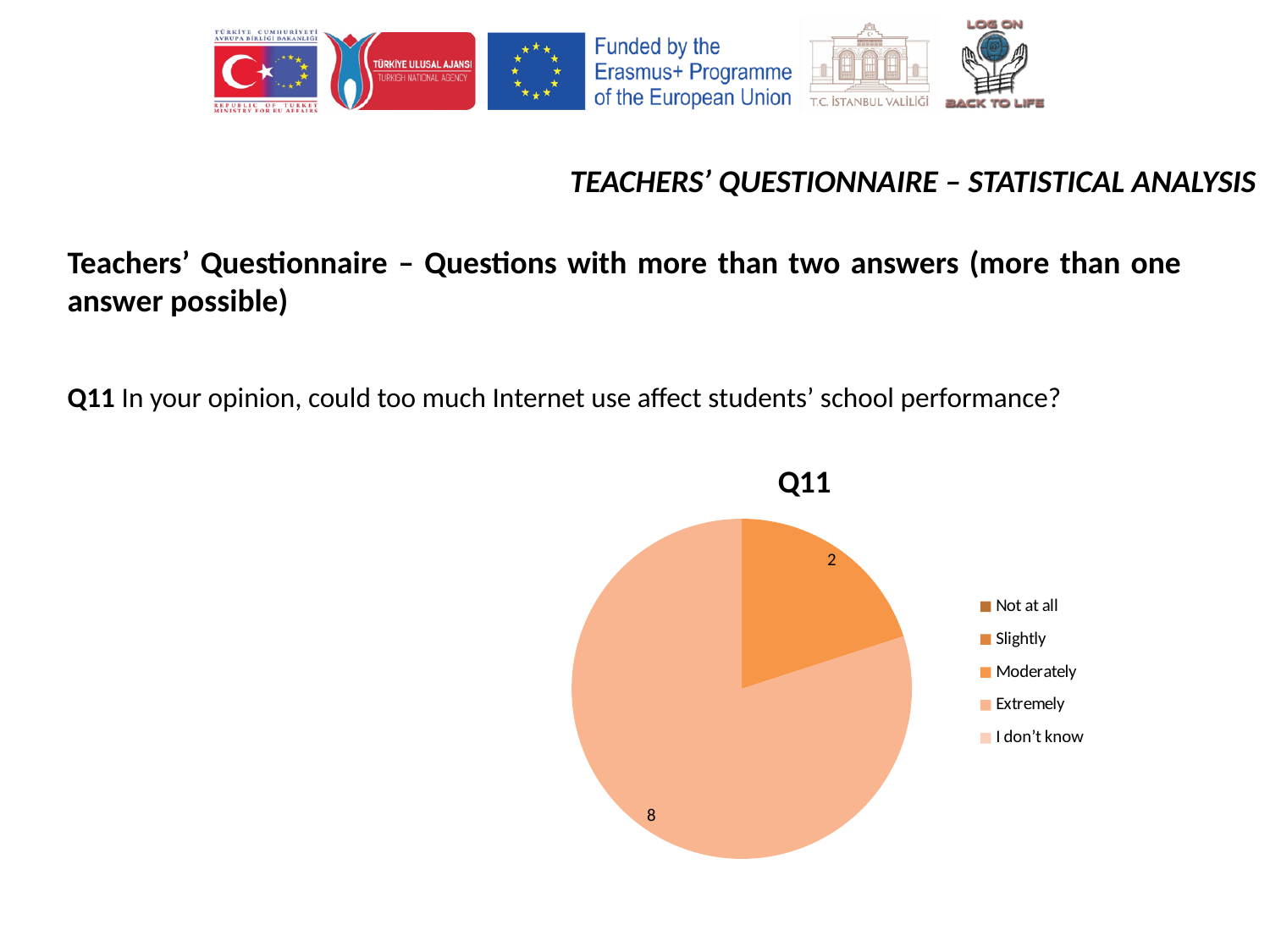
What is the value shown on the largest slice of the pie chart? 8 What share of the pie does the slice labelled 2 represent? 20% How many slices with data labels are visible in the pie chart? 2 What is the total of the labelled slice values in the pie chart? 10 What share of the pie does the slice labelled 8 represent? 80% What is the last entry listed in the chart's legend? I don't know What is the difference between the two labelled slice values in the pie chart? 6 How many entries does the chart's legend list? 5 What kind of chart is shown on the slide? pie chart Which is larger: the slice labelled 2 or the slice labelled 8? the slice labelled 8 What is the value shown on the smallest slice of the pie chart? 2 What is the title of the chart? Q11